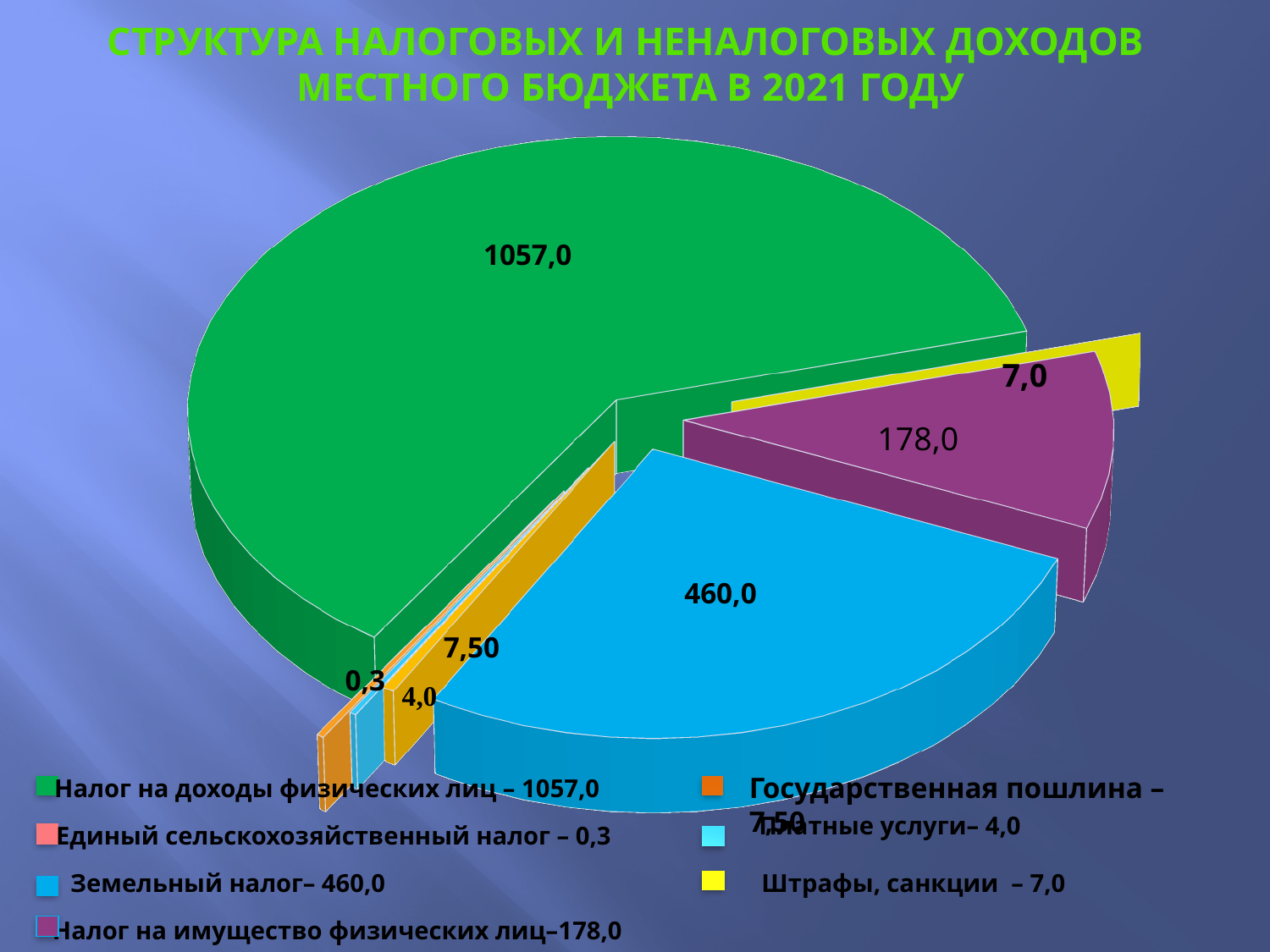
Which category has the largest slice of the pie? Налог на доходы физических лиц What is the value for Налог на доходы физических лиц? 1057,0 What is the value for Земельный налог? 460,0 Which is larger: Государственная пошлина or Штрафы, санкции? Государственная пошлина What is the difference between the values for Налог на доходы физических лиц and Земельный налог? 597,0 What type of chart is shown on the slide? pie chart What is the value for Платные услуги? 4,0 What is the value for Налог на имущество физических лиц? 178,0 Which category has the smallest value? Единый сельскохозяйственный налог What is the value for Государственная пошлина? 7,50 What is the title of the chart on the slide? СТРУКТУРА НАЛОГОВЫХ И НЕНАЛОГОВЫХ ДОХОДОВ МЕСТНОГО БЮДЖЕТА В 2021 ГОДУ How many categories does the pie chart show? 7